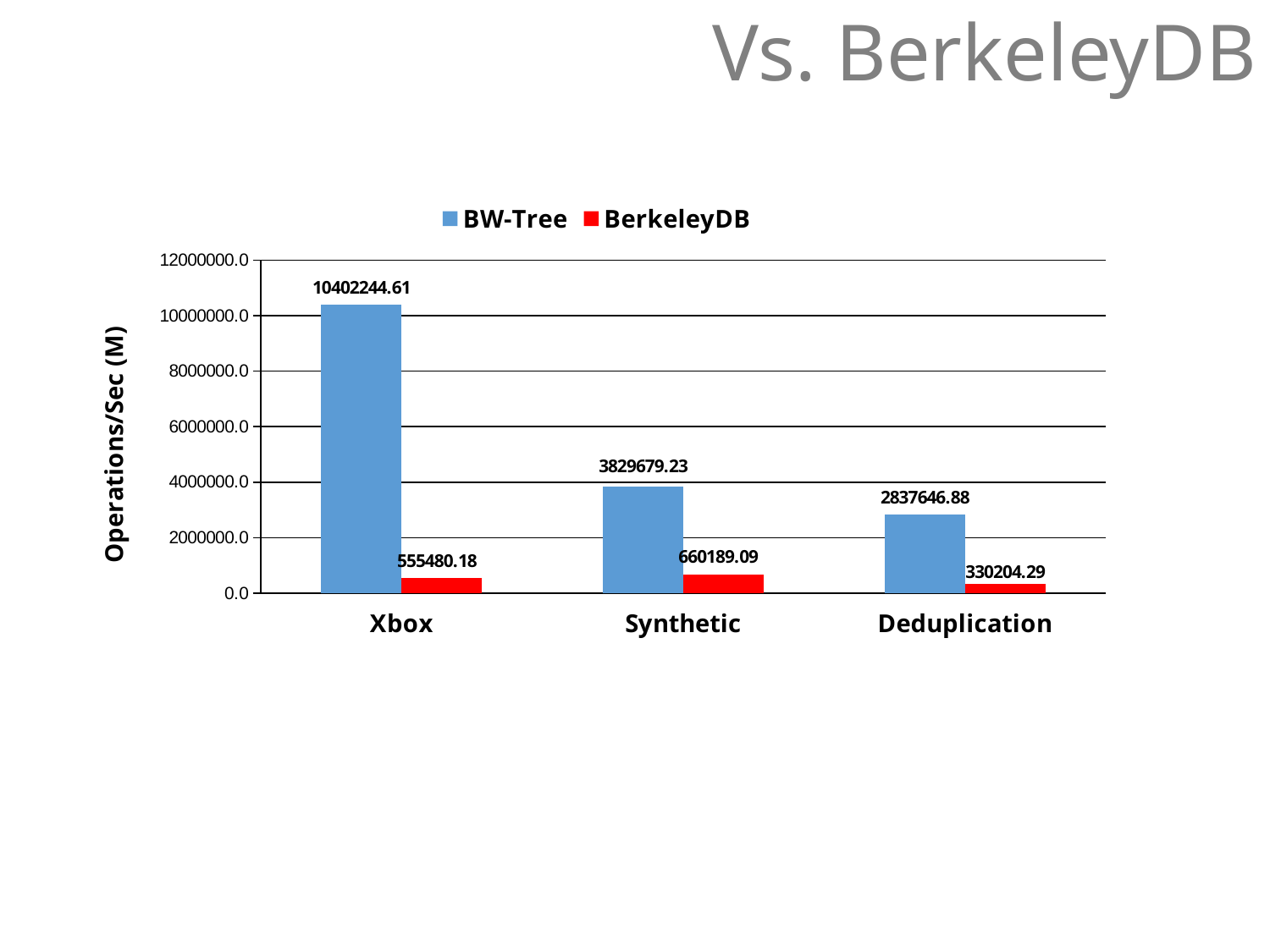
How many categories are shown on the x axis? 3 What is the BerkeleyDB value for Xbox? 555480.18 How many series does the legend list? 2 What kind of chart is shown on the slide? Bar chart What is the BW-Tree value for Xbox? 10402244.61 Which is larger, the BerkeleyDB value for Synthetic or the BerkeleyDB value for Xbox? Synthetic What is the difference between the BW-Tree and BerkeleyDB values for Xbox? 9846764.43 Which category has the lowest BerkeleyDB value? Deduplication What is the BW-Tree value for Deduplication? 2837646.88 Which category has the highest BW-Tree value? Xbox What is the BerkeleyDB value for Synthetic? 660189.09 What is the difference between the BW-Tree and BerkeleyDB values for Synthetic? 3169490.14